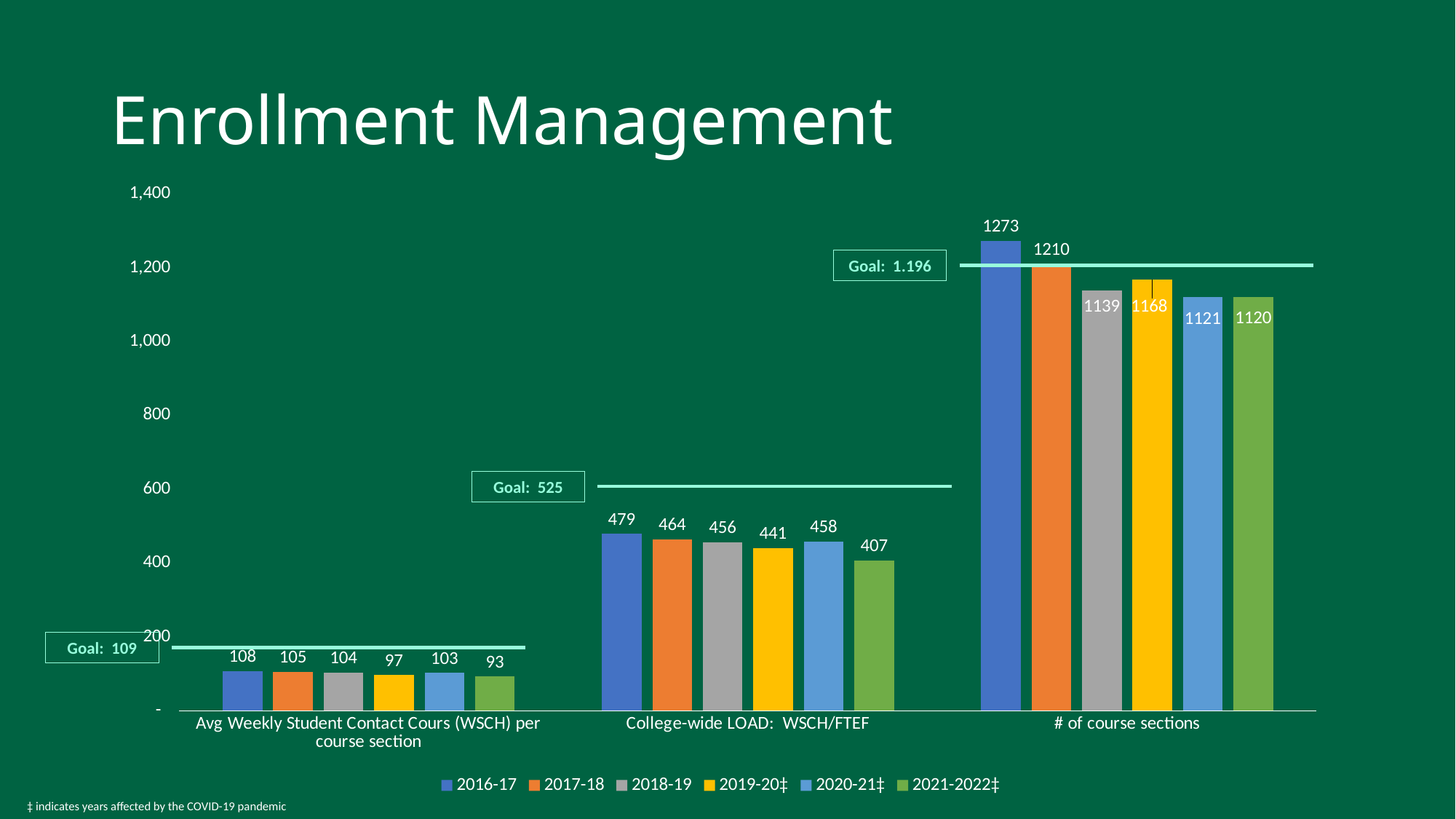
Which year has the highest value in the "College-wide LOAD: WSCH/FTEF" category? 2016-17 What is the value for 2019-20‡ in the "College-wide LOAD: WSCH/FTEF" category? 441 What is the goal shown for the "College-wide LOAD: WSCH/FTEF" category? 525 What kind of chart is shown on the slide? Bar chart What is the value for 2016-17 in the "# of course sections" category? 1273 Which year has the lowest value in the "# of course sections" category? 2021-2022‡ How many categories are shown on the x axis? 3 What is the difference between the 2016-17 and 2017-18 values in the "# of course sections" category? 63 What is the goal shown for the "Avg Weekly Student Contact Cours (WSCH) per course section" category? 109 How many series does the legend list? 6 What is the value for 2021-2022‡ in the "Avg Weekly Student Contact Cours (WSCH) per course section" category? 93 Which is larger in the "# of course sections" category: 2018-19 or 2019-20‡? 2019-20‡